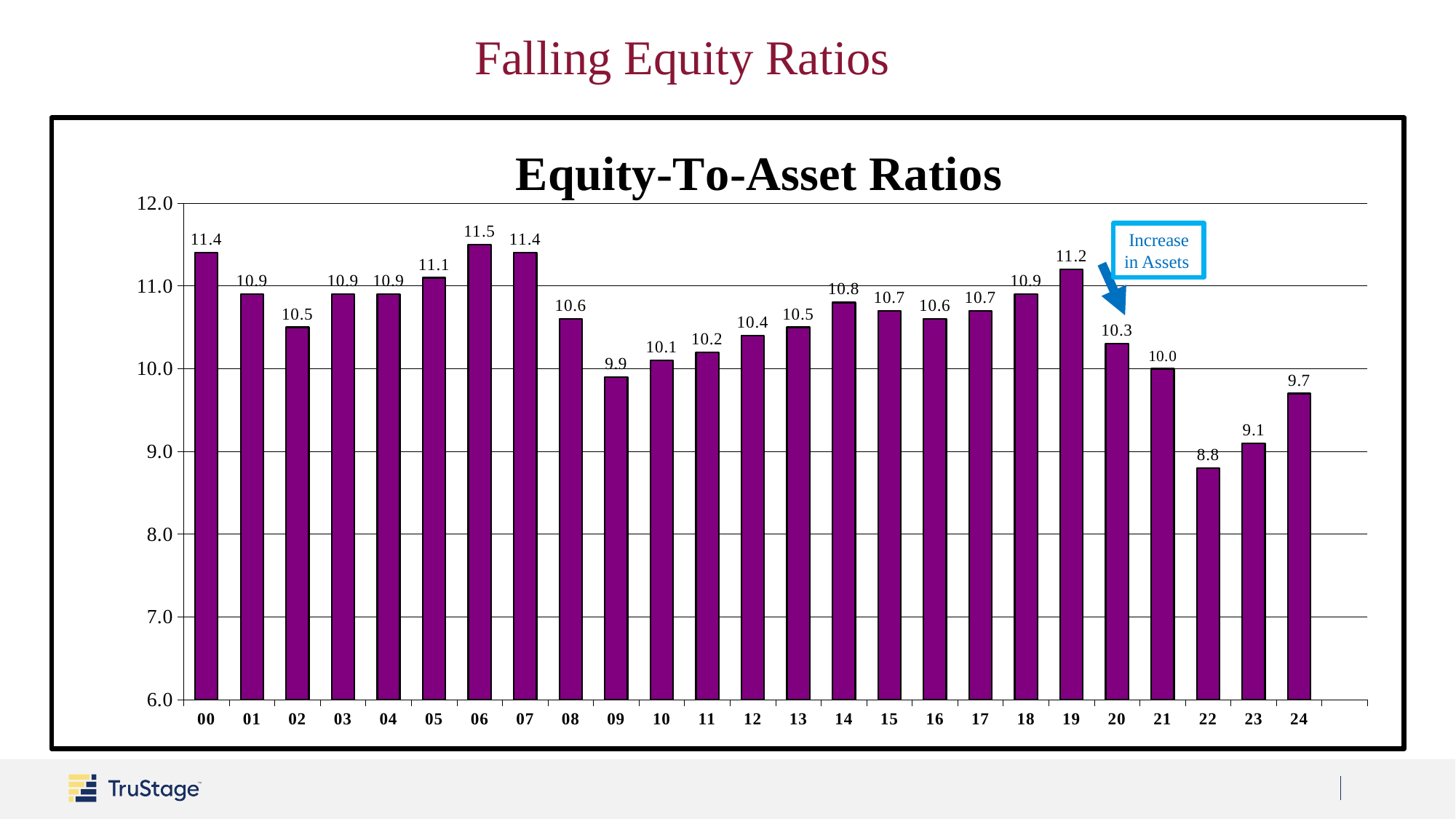
Is the value for 23 greater or less than 10.0? less Which year has the lowest equity-to-asset ratio? 22 What is the title of the chart? Equity-To-Asset Ratios What is the equity-to-asset ratio for 20? 10.3 How many years are shown on the x axis? 25 Which year has the highest equity-to-asset ratio? 06 What is the equity-to-asset ratio for 06? 11.5 What is the difference between the equity-to-asset ratio for 19 and for 20? 0.9 Which is larger, the equity-to-asset ratio for 09 or for 24? 09 Do the values rise or fall from 19 to 22? Fall What kind of chart is shown? Bar chart What is the equity-to-asset ratio for 22? 8.8